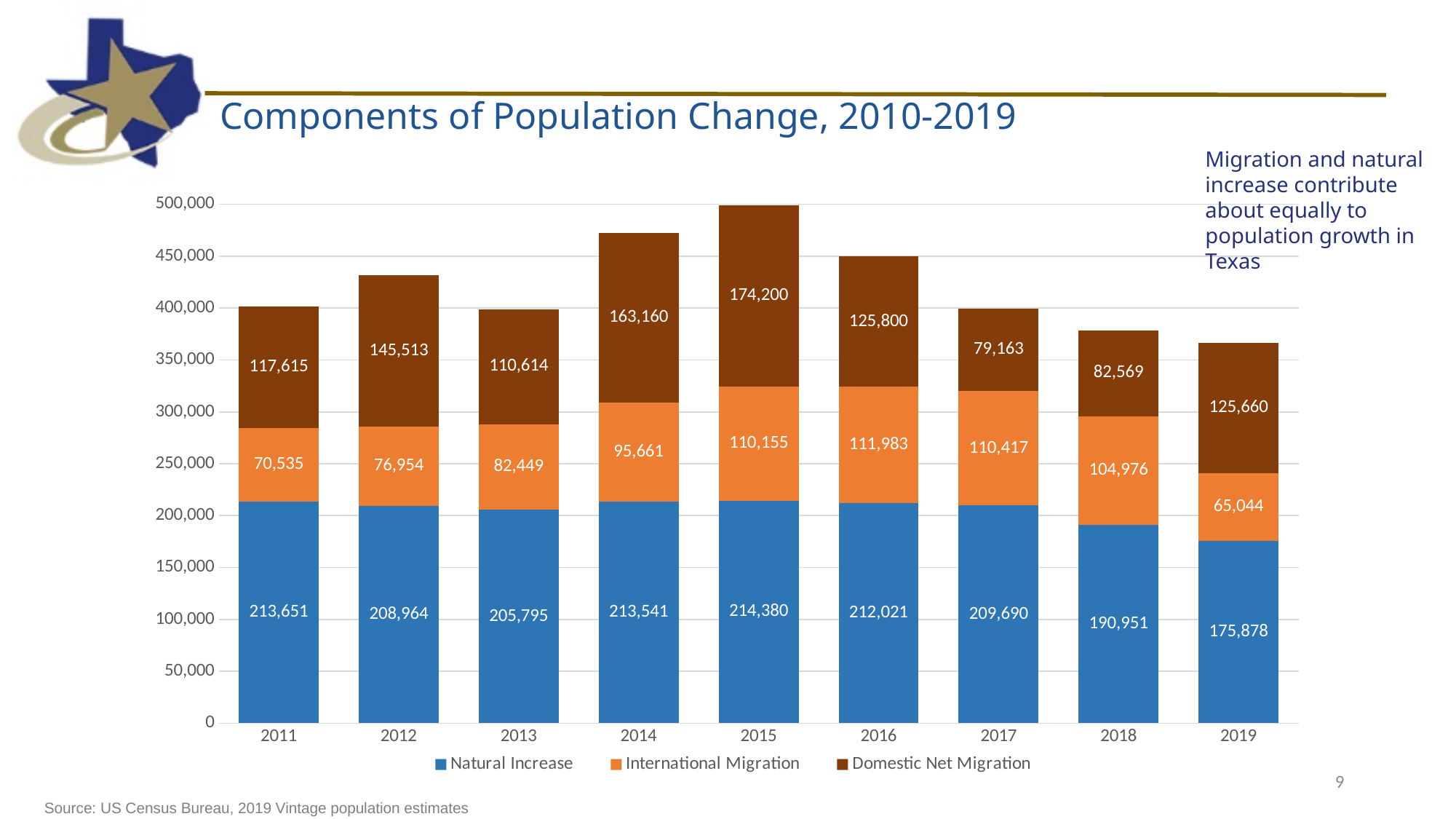
What is the International Migration value for 2018? 104,976 What is the difference between Domestic Net Migration in 2014 and in 2017? 83,997 What is the total of the stacked bar for 2011? 401,801 What is the Domestic Net Migration value for 2012? 145,513 How many years are shown on the x axis? 9 Which is larger: International Migration in 2016 or in 2019? 2016 In which year is Natural Increase lowest? 2019 What kind of chart is shown on the slide? Stacked bar chart What is the Natural Increase value for 2015? 214,380 What is the title of the chart? Components of Population Change, 2010-2019 In which year is Domestic Net Migration highest? 2015 How many series does the legend list? 3